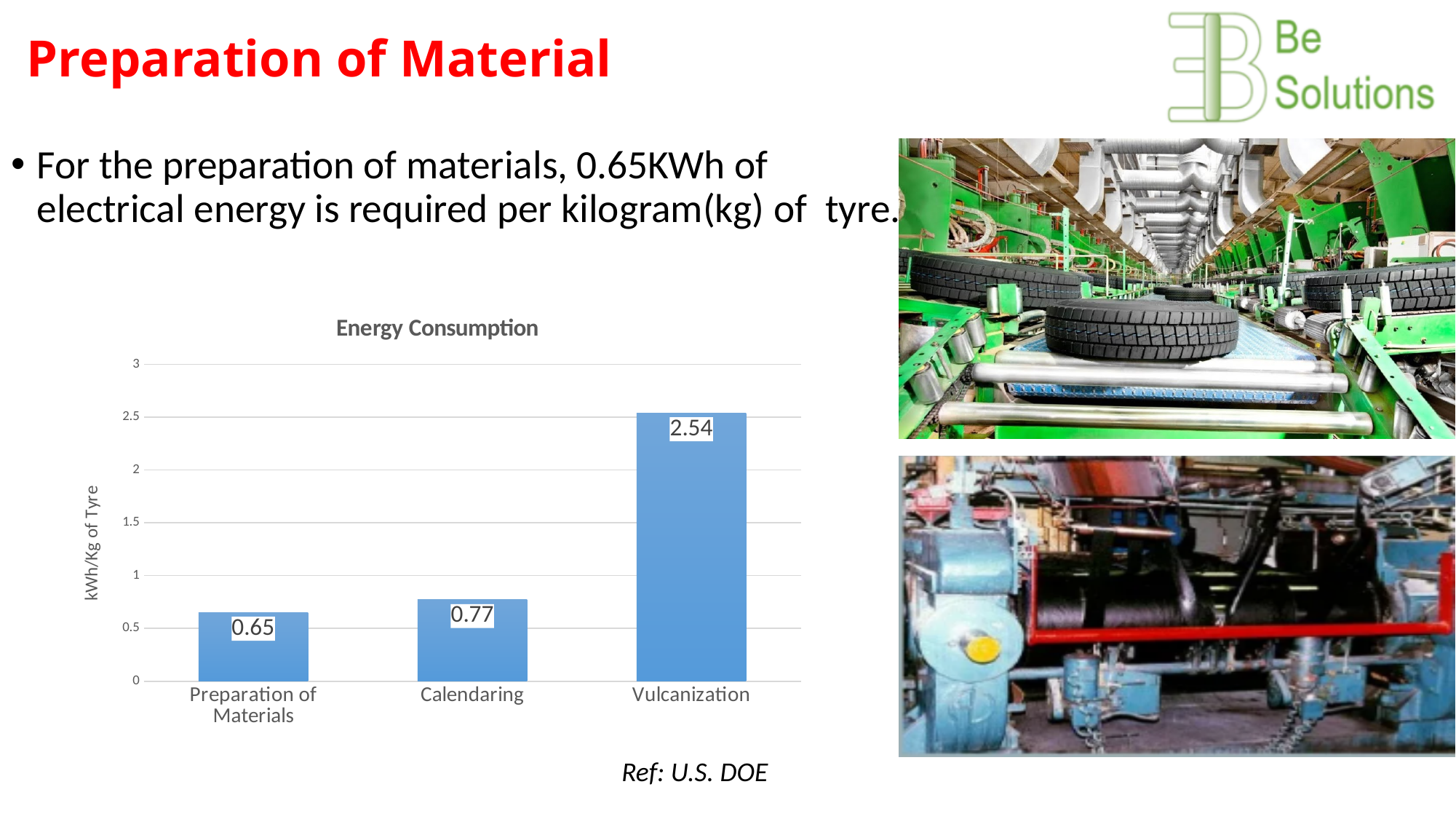
What is the title of the chart? Energy Consumption Which category has the lowest energy consumption? Preparation of Materials How many categories are shown in the chart? 3 What is the energy consumption value for Preparation of Materials? 0.65 What kind of chart is shown on the slide? Bar chart Which has a larger energy consumption, Calendaring or Preparation of Materials? Calendaring What is the energy consumption value for Calendaring? 0.77 Is the value for Vulcanization greater or less than 2? greater What is the difference in energy consumption between Calendaring and Preparation of Materials? 0.12 Which category has the highest energy consumption? Vulcanization What is the difference in energy consumption between Vulcanization and Calendaring? 1.77 What is the energy consumption value for Vulcanization? 2.54